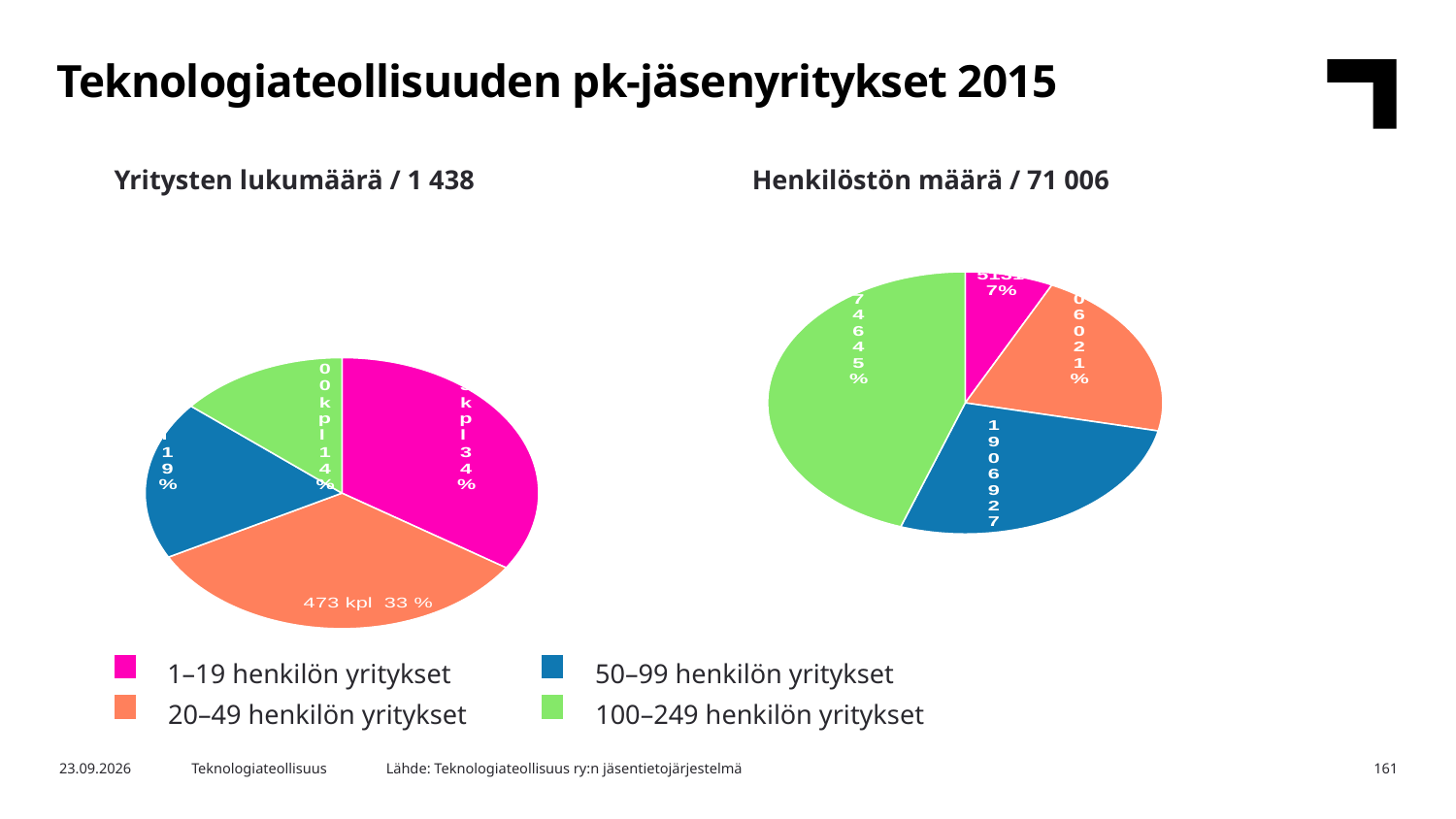
In the left chart 'Yritysten lukumäärä / 1 438', what share do the 50–99 henkilön yritykset have? 19% In the right chart 'Henkilöstön määrä / 71 006', what share do the 1–19 henkilön yritykset have? 7% In the left chart 'Yritysten lukumäärä / 1 438', which slice is larger: 50–99 henkilön yritykset or 100–249 henkilön yritykset? 50–99 henkilön yritykset In the left chart 'Yritysten lukumäärä / 1 438', what share do the 20–49 henkilön yritykset have? 33 % In the right chart 'Henkilöstön määrä / 71 006', which category has the smallest slice? 1–19 henkilön yritykset In the right chart 'Henkilöstön määrä / 71 006', which category has the largest slice? 100–249 henkilön yritykset How many categories does the legend list for the pie charts? 4 In the left chart 'Yritysten lukumäärä / 1 438', how many companies (kpl) are in the 20–49 henkilön yritykset slice? 473 kpl What kind of chart is the left chart titled 'Yritysten lukumäärä / 1 438'? pie chart In the left chart 'Yritysten lukumäärä / 1 438', which category has the smallest slice? 100–249 henkilön yritykset